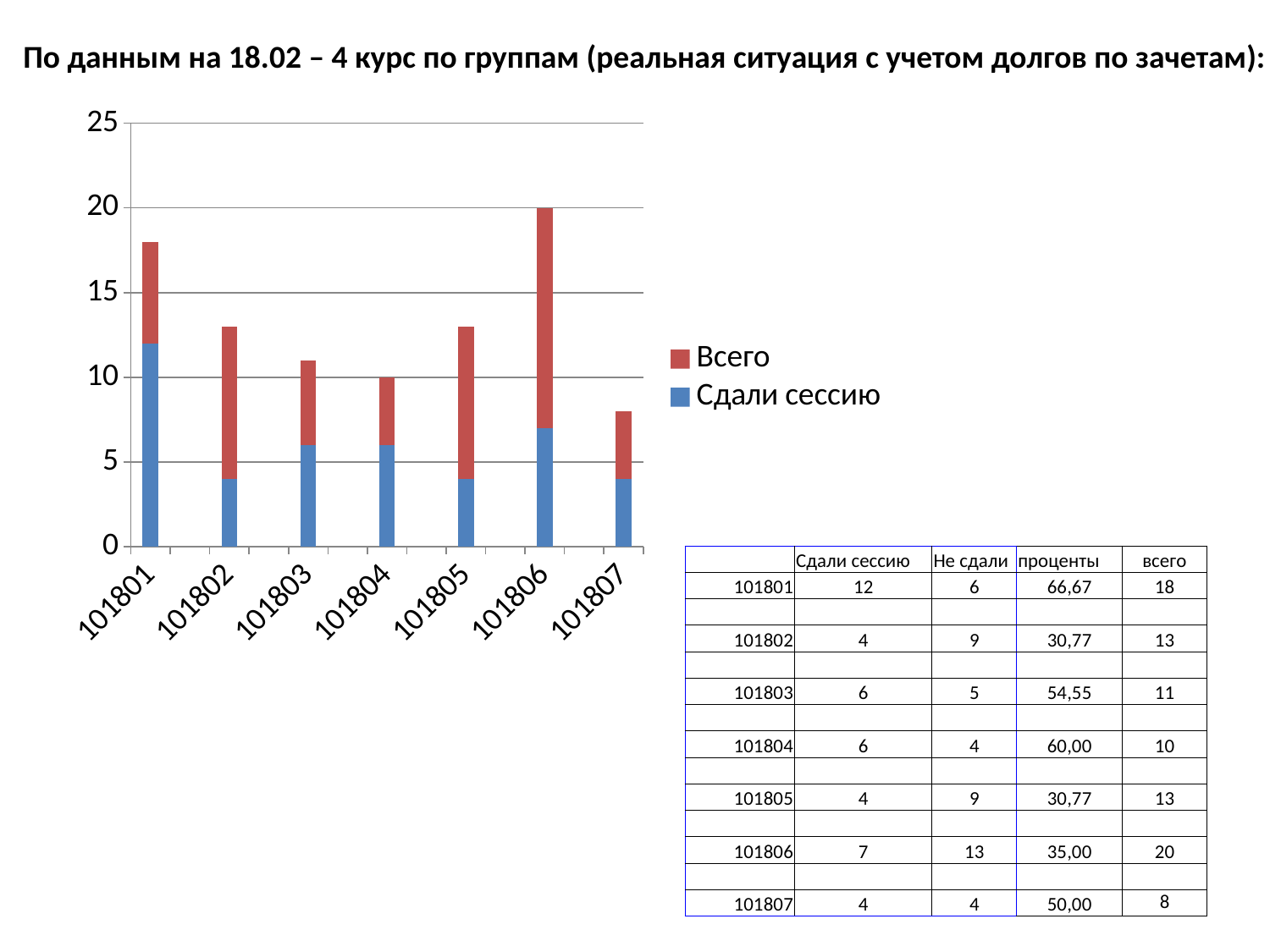
Is the 'Сдали сессию' value for group 101806 greater or less than 5? greater What is the total height of the stacked bar for group 101804? 10 Is the total bar height for group 101801 greater or less than 15? greater Which group has the taller stacked bar, 101802 or 101803? 101802 How many series does the chart legend list? 2 What is the value of 'Сдали сессию' for group 101801? 12 What colour represents the 'Сдали сессию' series in the chart? blue How many groups are shown along the x axis of the chart? 7 What is the total height of the stacked bar for group 101806? 20 Which group has the shortest stacked bar in the chart? 101807 Which group has the tallest stacked bar in the chart? 101806 What kind of chart is shown on the slide? bar chart